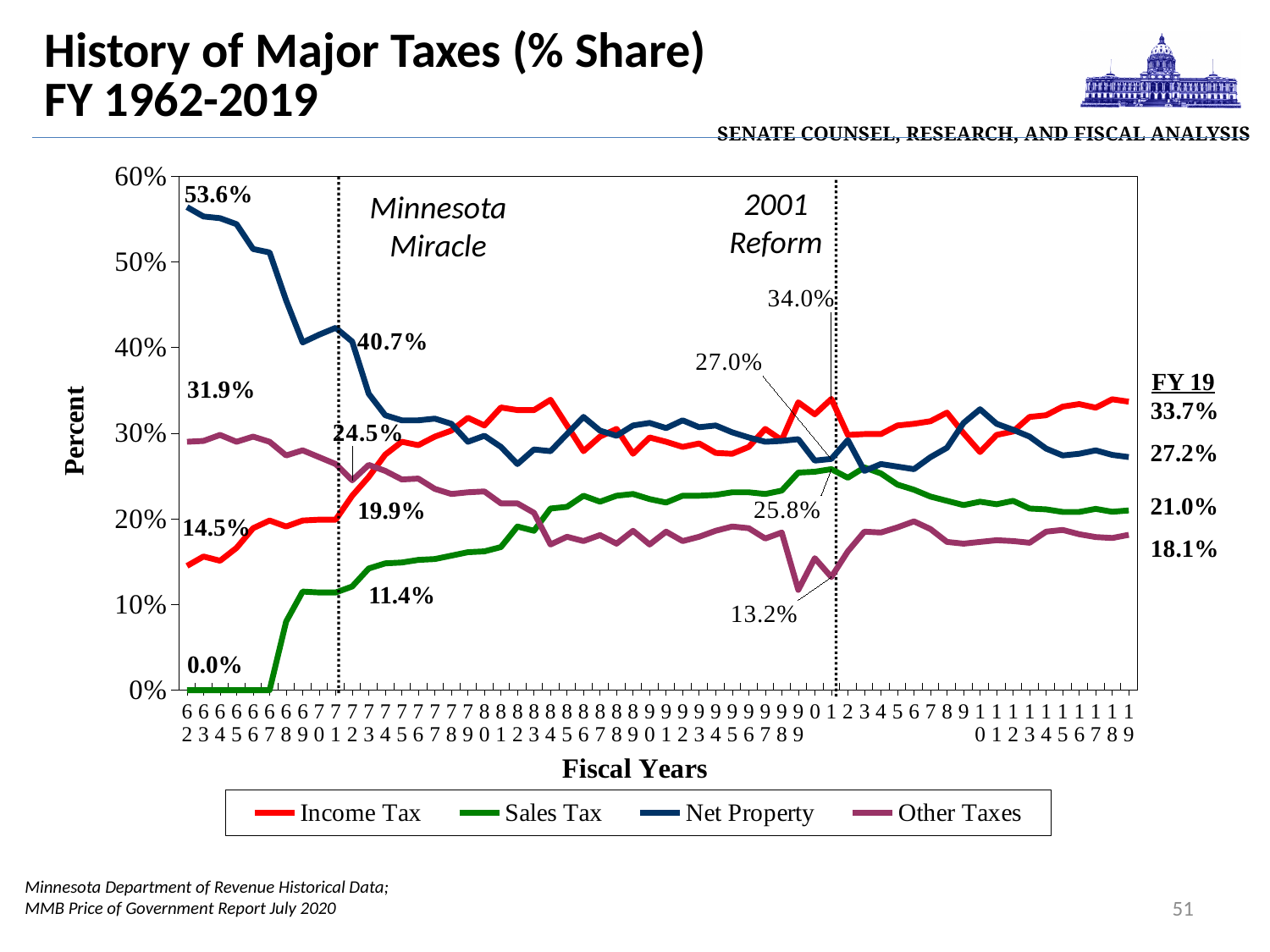
At the 2001 Reform marker, which is larger: the Income Tax share (34.0%) or the Net Property share (27.0%)? Income Tax What is the Income Tax share in FY 19? 33.7% What is the Sales Tax share in FY 19? 21.0% What is the Other Taxes share in FY 19? 18.1% What kind of chart is shown on the slide? Line chart What was the Net Property share in FY 1962, according to the data label? 53.6% How many series does the legend list? 4 Does the Sales Tax share rise or fall from FY 1962 to FY 2019? Rise Which tax has the highest share in FY 19? Income Tax What is the difference between the Income Tax share and the Net Property share in FY 19? 6.5 percentage points Does the Net Property share rise or fall from FY 1962 to FY 2019? Fall What colour is the Sales Tax line in the legend? Green